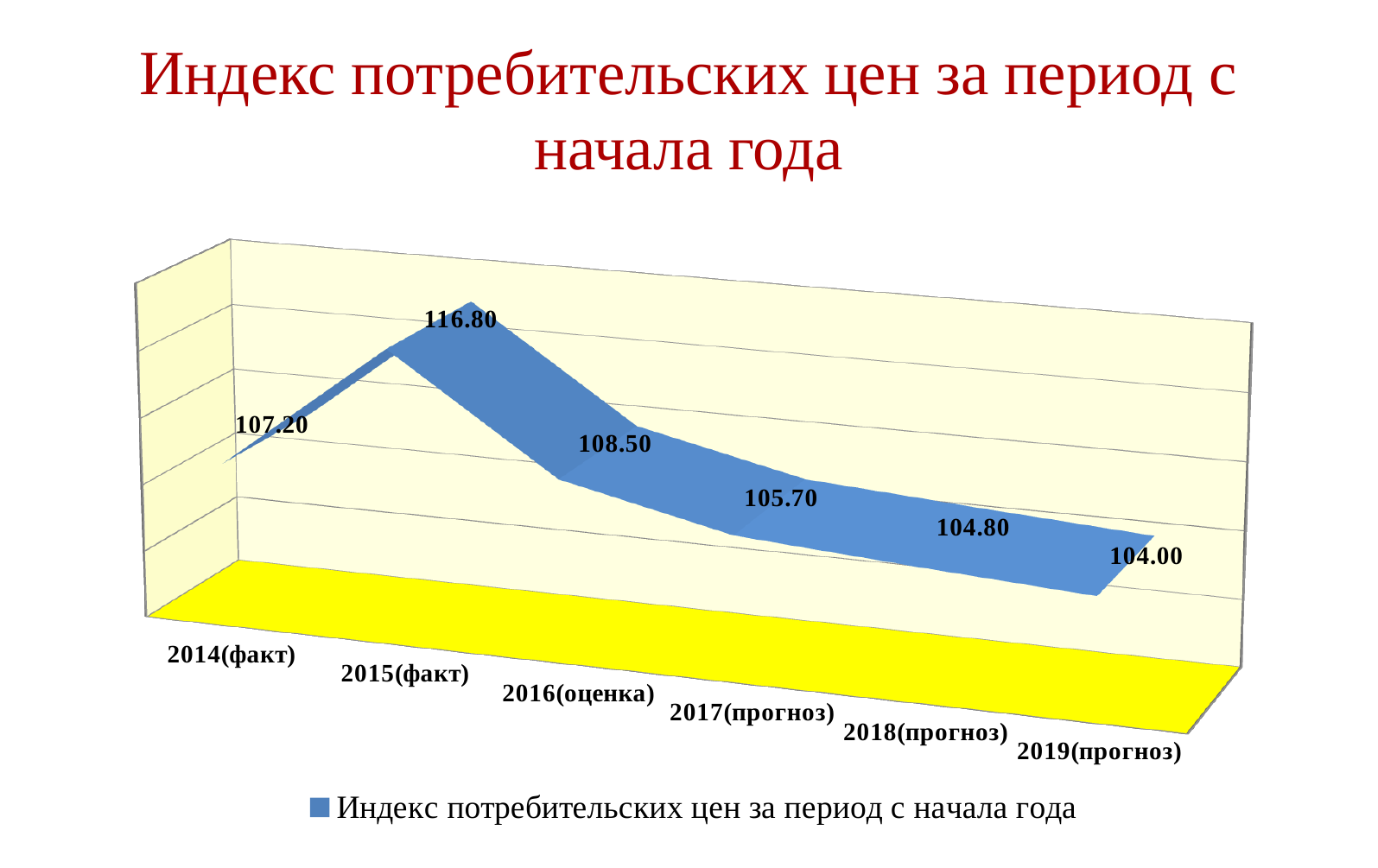
What is the difference between the values for 2014(факт) and 2019(прогноз)? 3.20 What kind of chart is shown on the slide? line chart What is the value for 2017(прогноз)? 105.70 Which category has the lowest value? 2019(прогноз) What is the value for 2019(прогноз)? 104.00 Which category has the highest value? 2015(факт) Which is larger, the value for 2016(оценка) or the value for 2018(прогноз)? 2016(оценка) How many series does the legend list? 1 What is the difference between the values for 2015(факт) and 2016(оценка)? 8.30 What is the value for 2014(факт)? 107.20 How many categories are plotted on the x axis? 6 What is the value for 2015(факт)? 116.80